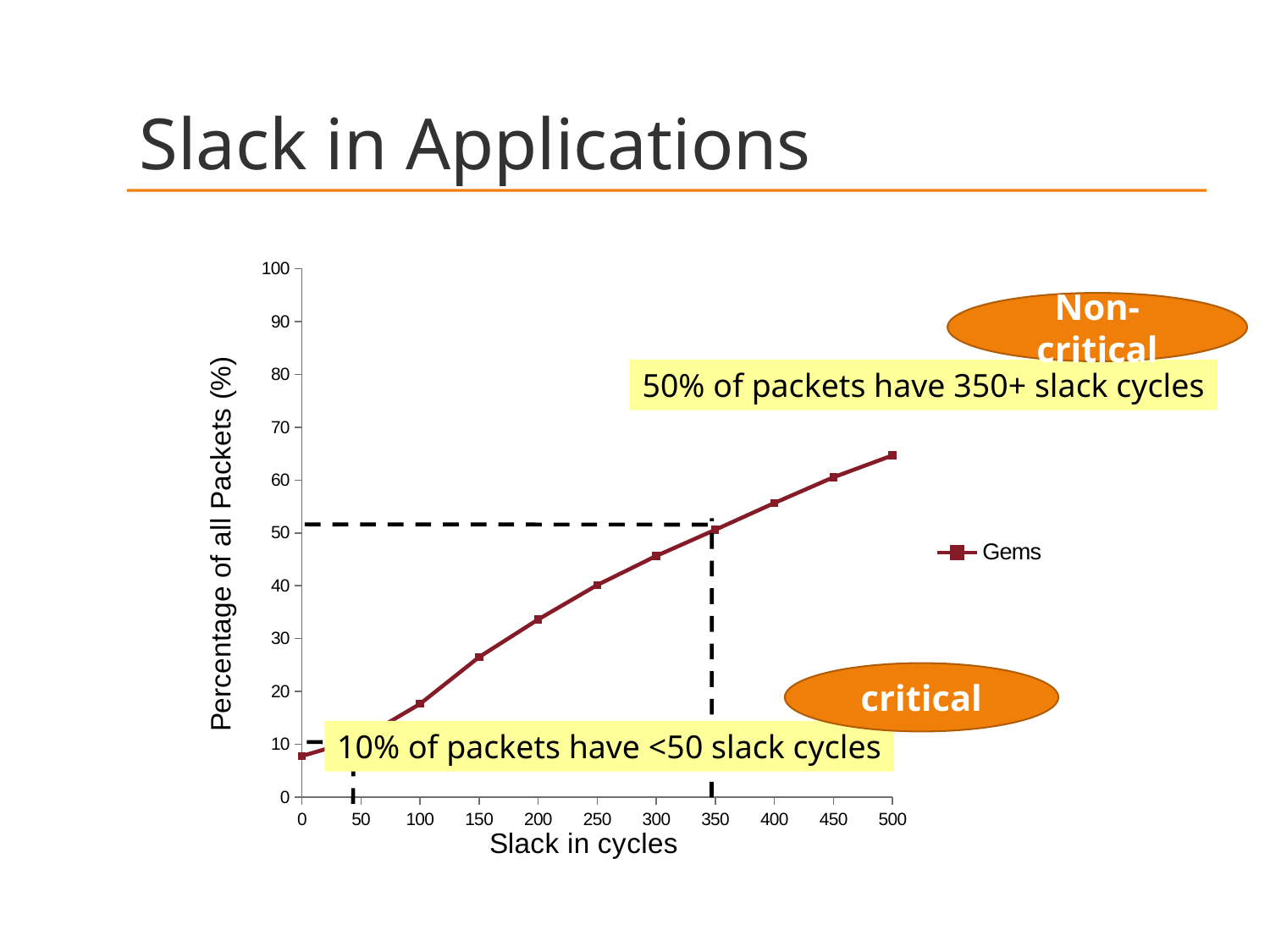
What is the name of the series shown in the legend? Gems At which slack value is the percentage of all packets lowest? 0 Is the value for a slack of 250 cycles greater or less than 30? greater What kind of chart is shown on the slide? line chart What is the title of the x axis? Slack in cycles Do the values rise or fall as slack in cycles increases along the x axis? rise Is the value for a slack of 100 cycles greater or less than 20? less Which has a higher percentage of all packets: a slack of 150 cycles or a slack of 400 cycles? 400 At which slack value is the percentage of all packets highest? 500 How many series does the legend list? 1 Is the value for a slack of 500 cycles greater or less than 60? greater